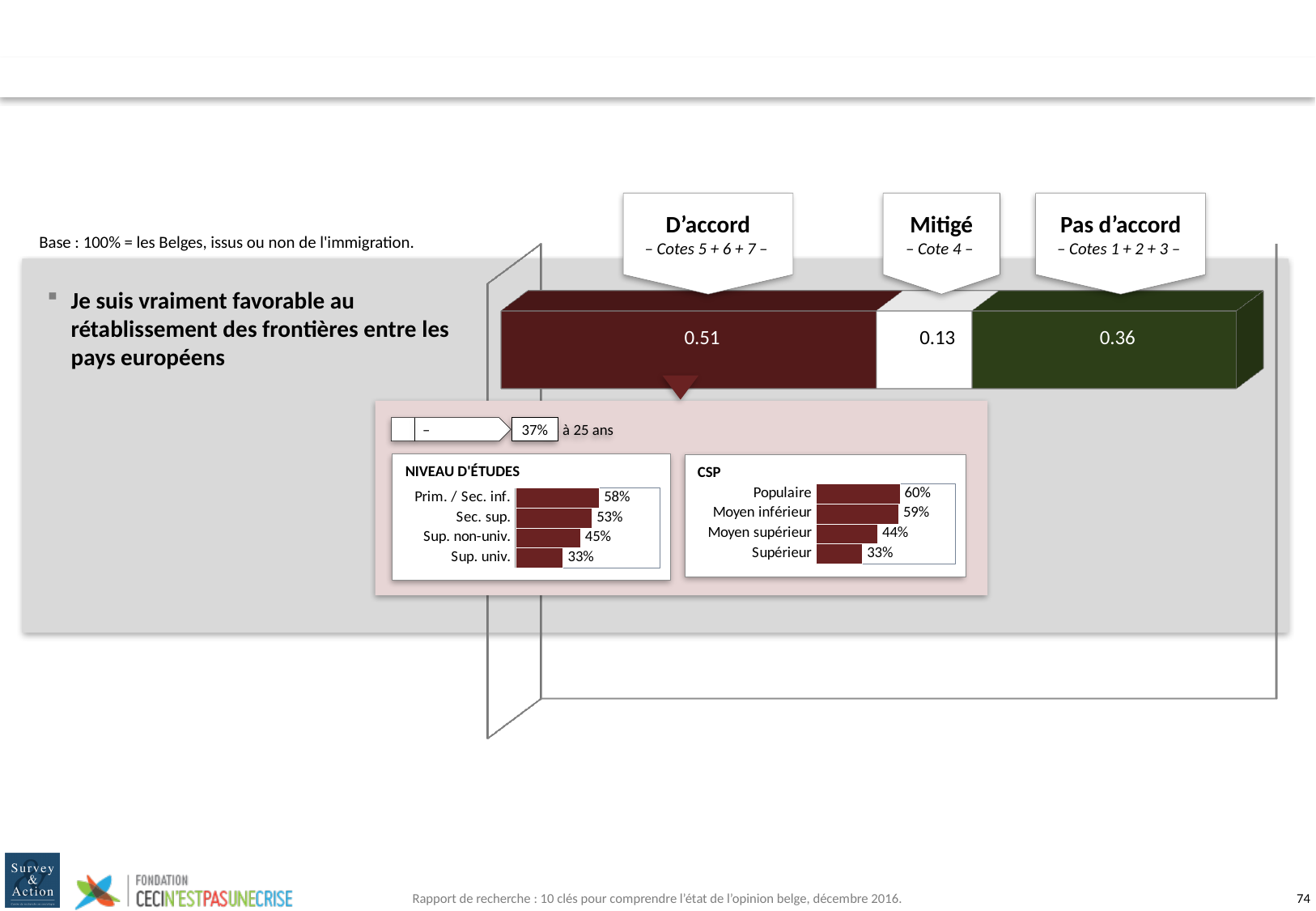
In the 'CSP' chart, what is the value for 'Moyen supérieur'? 44% In the main stacked bar chart, what is the value for 'Mitigé'? 0.13 In the 'CSP' chart, how many categories are shown? 4 In the main stacked bar chart, what is the difference between the 'D'accord' and 'Pas d'accord' values? 0.15 In the main stacked bar chart, what is the value for 'Pas d'accord'? 0.36 In the main stacked bar chart, which segment is the smallest? Mitigé In the 'CSP' chart, which category has the lowest value? Supérieur In the 'NIVEAU D'ÉTUDES' chart, what is the value for 'Sec. sup.'? 53% In the 'CSP' chart, do the values rise or fall from 'Populaire' down to 'Supérieur'? fall In the 'NIVEAU D'ÉTUDES' chart, which category has the highest value? Prim. / Sec. inf. In the 'NIVEAU D'ÉTUDES' chart, what is the difference between 'Prim. / Sec. inf.' and 'Sup. univ.'? 25% In the main stacked bar chart, what is the value for 'D'accord'? 0.51